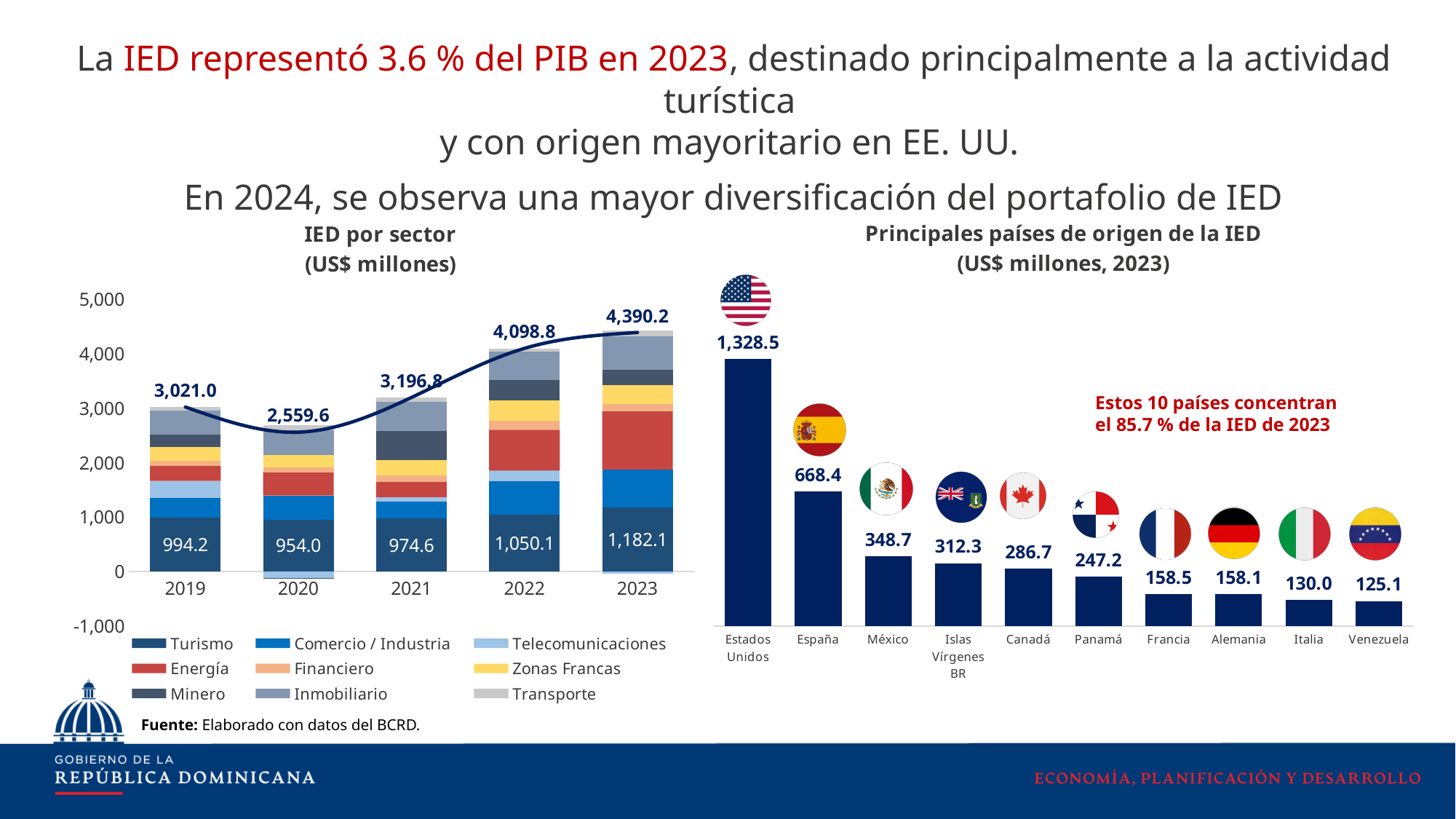
In the 'IED por sector' chart, is the Turismo value for 2022 larger or smaller than the Turismo value for 2021? larger In the 'Principales países de origen de la IED' chart, what is the value for España? 668.4 In the 'Principales países de origen de la IED' chart, which country has the highest value? Estados Unidos In the 'Principales países de origen de la IED' chart, what is the difference between the values for México and Canadá? 62.0 In the 'IED por sector' chart, what is the difference between the 2023 total and the 2022 total? 291.4 In the 'Principales países de origen de la IED' chart, how many countries are shown? 10 In the 'IED por sector' chart, which year has the lowest total IED? 2020 In the 'IED por sector' chart, what is the Turismo value for 2020? 954.0 In the 'IED por sector' chart, what is the total IED for 2023? 4,390.2 In the 'Principales países de origen de la IED' chart, which country has the lowest value? Venezuela What kind of chart is the 'Principales países de origen de la IED' chart? bar chart In the 'IED por sector' chart, how many series does the legend list? 9